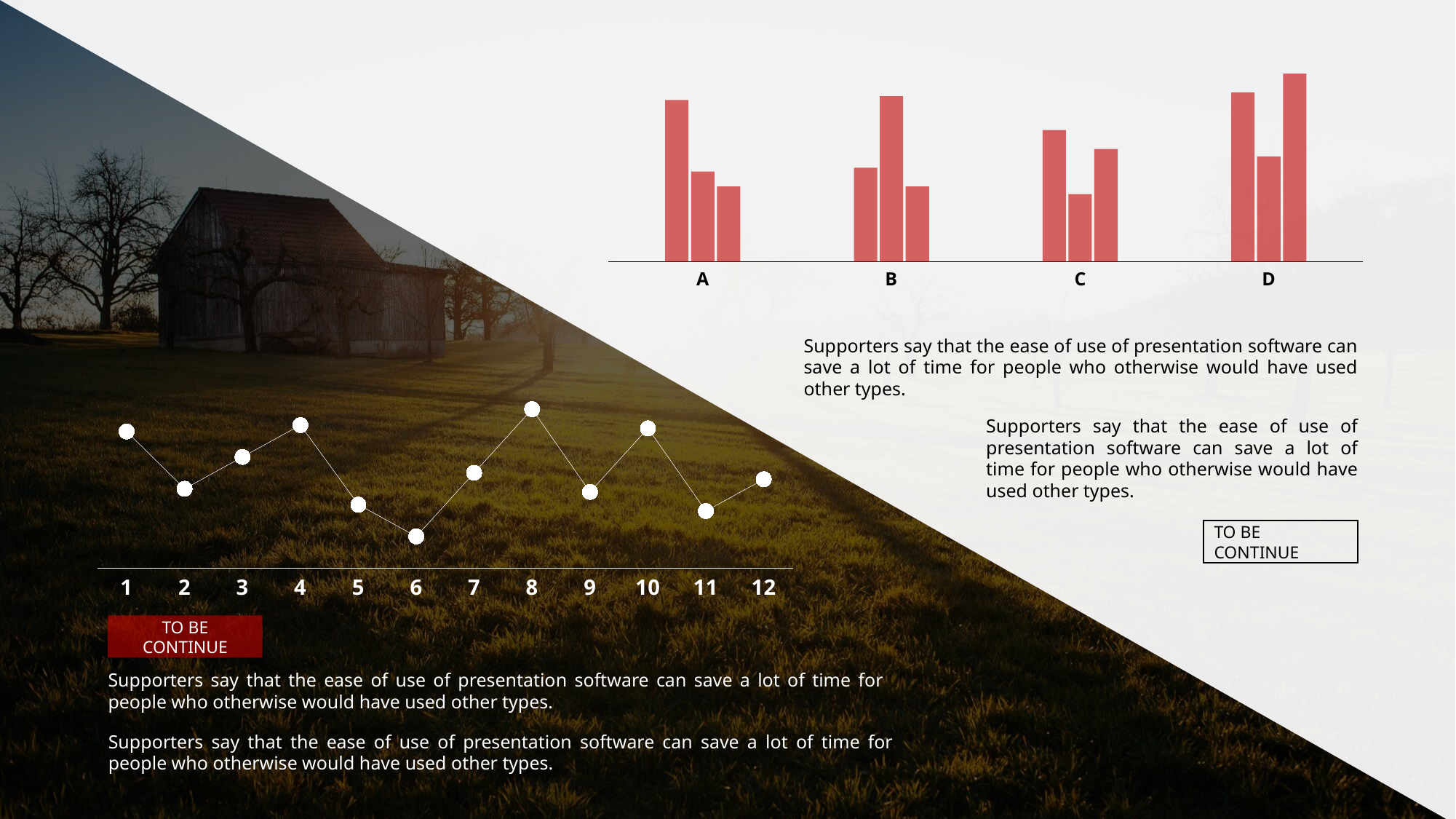
How many bars are plotted for each category in the bar chart at the top right? 3 In the line chart at the bottom left, does the value rise or fall from point 6 to point 8? rise What kind of chart is shown at the top right of the slide? bar chart In the bar chart at the top right, is the second bar of category B taller or shorter than the second bar of category C? taller How many categories are shown on the x axis of the bar chart at the top right? 4 What kind of chart is shown at the bottom left of the slide? line chart In the line chart at the bottom left, does the value rise or fall from point 4 to point 6? fall In the bar chart at the top right, is the first bar of category A taller or shorter than the third bar of category A? taller In the bar chart at the top right, which category contains the tallest bar? D In the line chart at the bottom left, which point has the lowest value? 6 How many points are plotted in the line chart at the bottom left? 12 In the line chart at the bottom left, which point has the highest value? 8